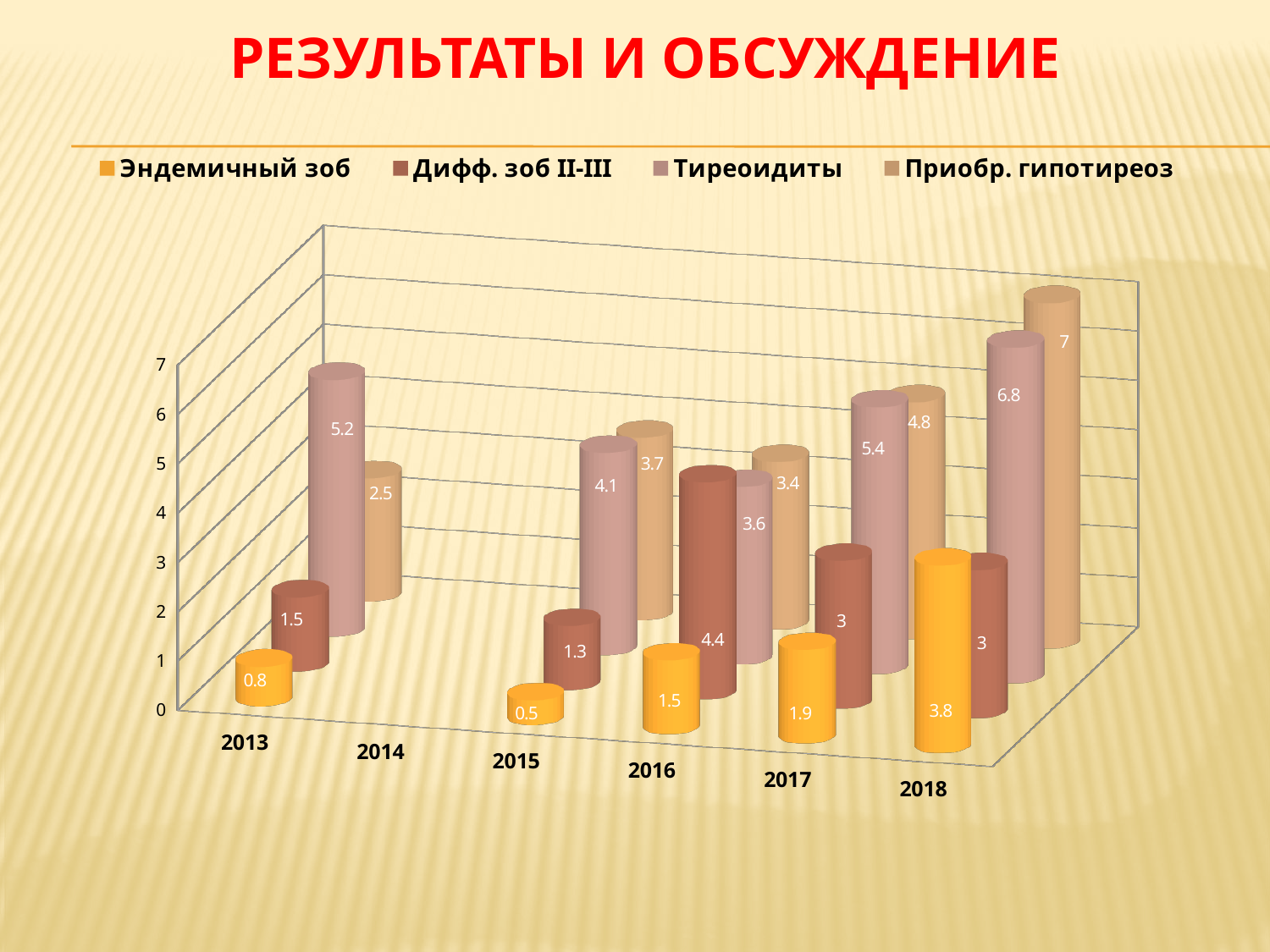
How many year labels are shown on the x axis? 6 What is the difference between Приобр. гипотиреоз and Эндемичный зоб in 2018? 3.2 What is the value for Эндемичный зоб in 2013? 0.8 What kind of chart is shown on the slide? bar chart What is the value for Эндемичный зоб in 2018? 3.8 What is the value for Тиреоидиты in 2013? 5.2 In 2013, which is larger: Тиреоидиты or Приобр. гипотиреоз? Тиреоидиты What is the lowest value shown for Эндемичный зоб? 0.5 How many series does the legend list? 4 What is the title of the slide? РЕЗУЛЬТАТЫ И ОБСУЖДЕНИЕ What is the value for Приобр. гипотиреоз in 2018? 7 What is the highest value shown for Тиреоидиты? 6.8